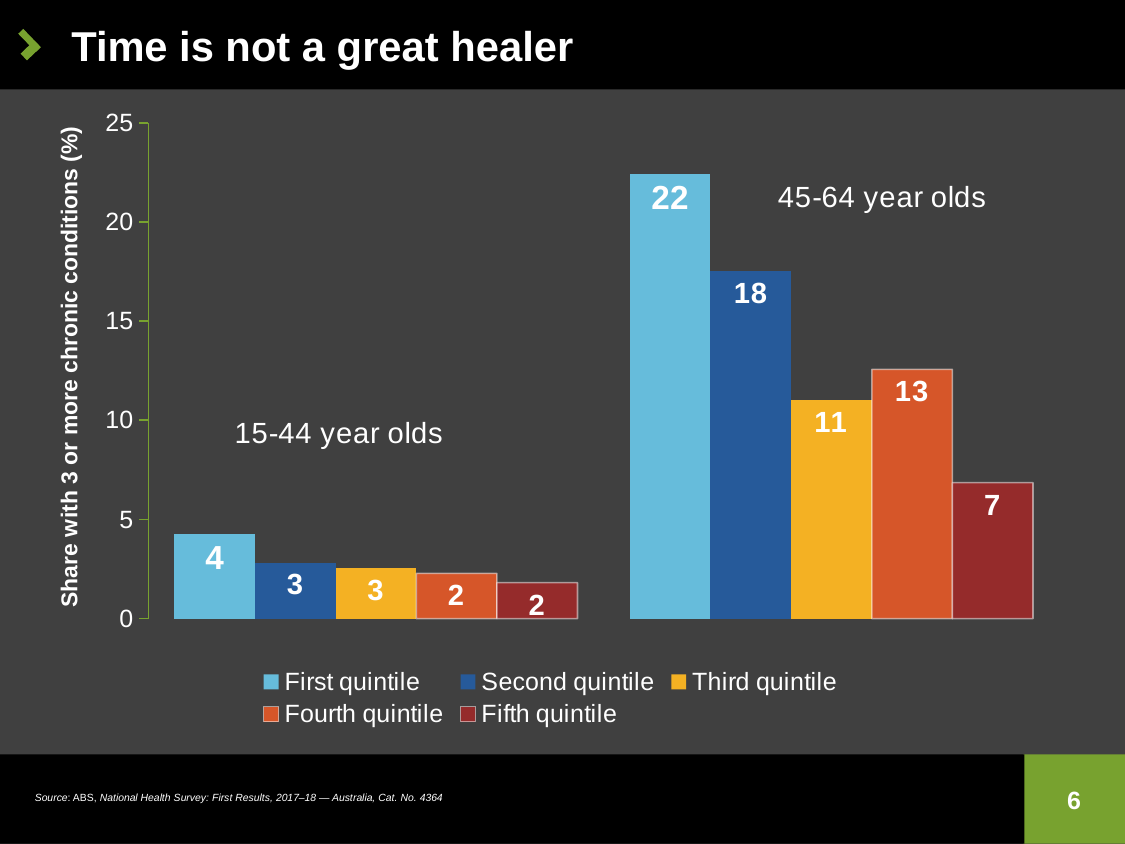
What is the value for the Fifth quintile among 15-44 year olds? 2 Which quintile has the lowest share among 45-64 year olds? Fifth quintile What is the value for the First quintile among 45-64 year olds? 22 What is the difference between the Second quintile and Fourth quintile values among 45-64 year olds? 5 Which quintile has the highest share among 45-64 year olds? First quintile What is the label of the vertical axis? Share with 3 or more chronic conditions (%) How many series does the legend list? 5 What is the difference between the First quintile values for 45-64 year olds and 15-44 year olds? 18 Which is larger: the Fourth quintile value for 45-64 year olds or the Third quintile value for 45-64 year olds? Fourth quintile What kind of chart is shown on the slide? Bar chart Is the value for the Second quintile among 45-64 year olds greater or less than 15? greater What is the value for the Third quintile among 45-64 year olds? 11